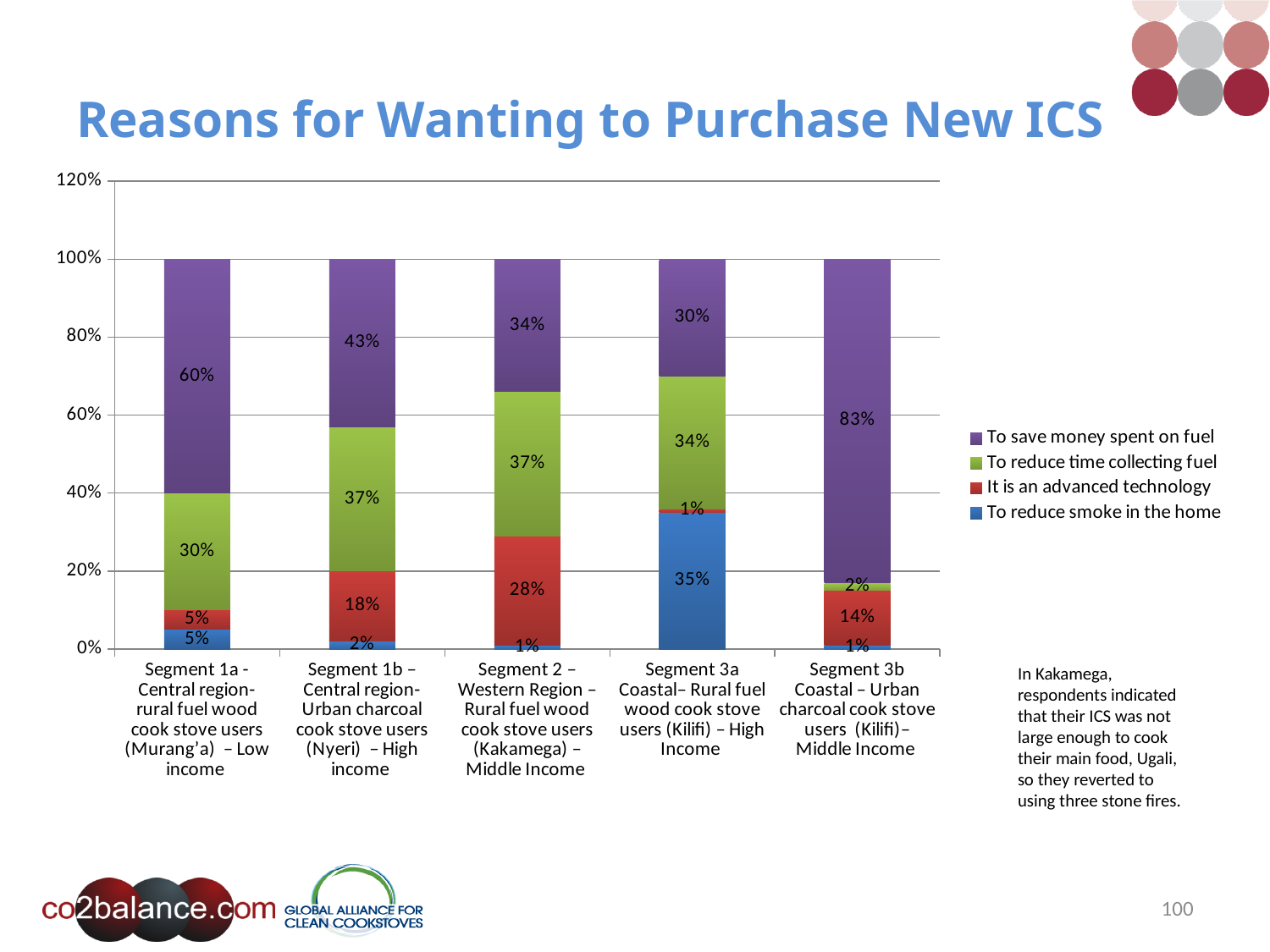
Which colour represents 'To reduce smoke in the home' in the legend? Blue Which segment has the highest value for 'To save money spent on fuel'? Segment 3b – Coastal – Urban charcoal cook stove users (Kilifi) – Middle Income What is the total of the stacked bar for Segment 1a (Central region – rural fuel wood cook stove users, Murang'a)? 100% How many segments are shown on the x axis of the chart? 5 What is the value for 'To reduce smoke in the home' for Segment 3a (Coastal – Rural fuel wood cook stove users, Kilifi)? 35% For Segment 1a (Central region – rural fuel wood cook stove users, Murang'a), how much larger is 'To save money spent on fuel' than 'To reduce time collecting fuel'? 30% What is the value for 'It is an advanced technology' for Segment 1b (Central region – Urban charcoal cook stove users, Nyeri)? 18% How many series does the legend list? 4 What percentage of Segment 3b (Coastal – Urban charcoal cook stove users, Kilifi) gave 'To save money spent on fuel' as a reason? 83% What kind of chart is shown on the slide? Stacked bar chart Which segment has the lowest value for 'To reduce time collecting fuel'? Segment 3b – Coastal – Urban charcoal cook stove users (Kilifi) – Middle Income Which segment has a larger value for 'It is an advanced technology': Segment 2 (Western Region, Kakamega) or Segment 1b (Central region, Nyeri)? Segment 2 – Western Region – Rural fuel wood cook stove users (Kakamega)